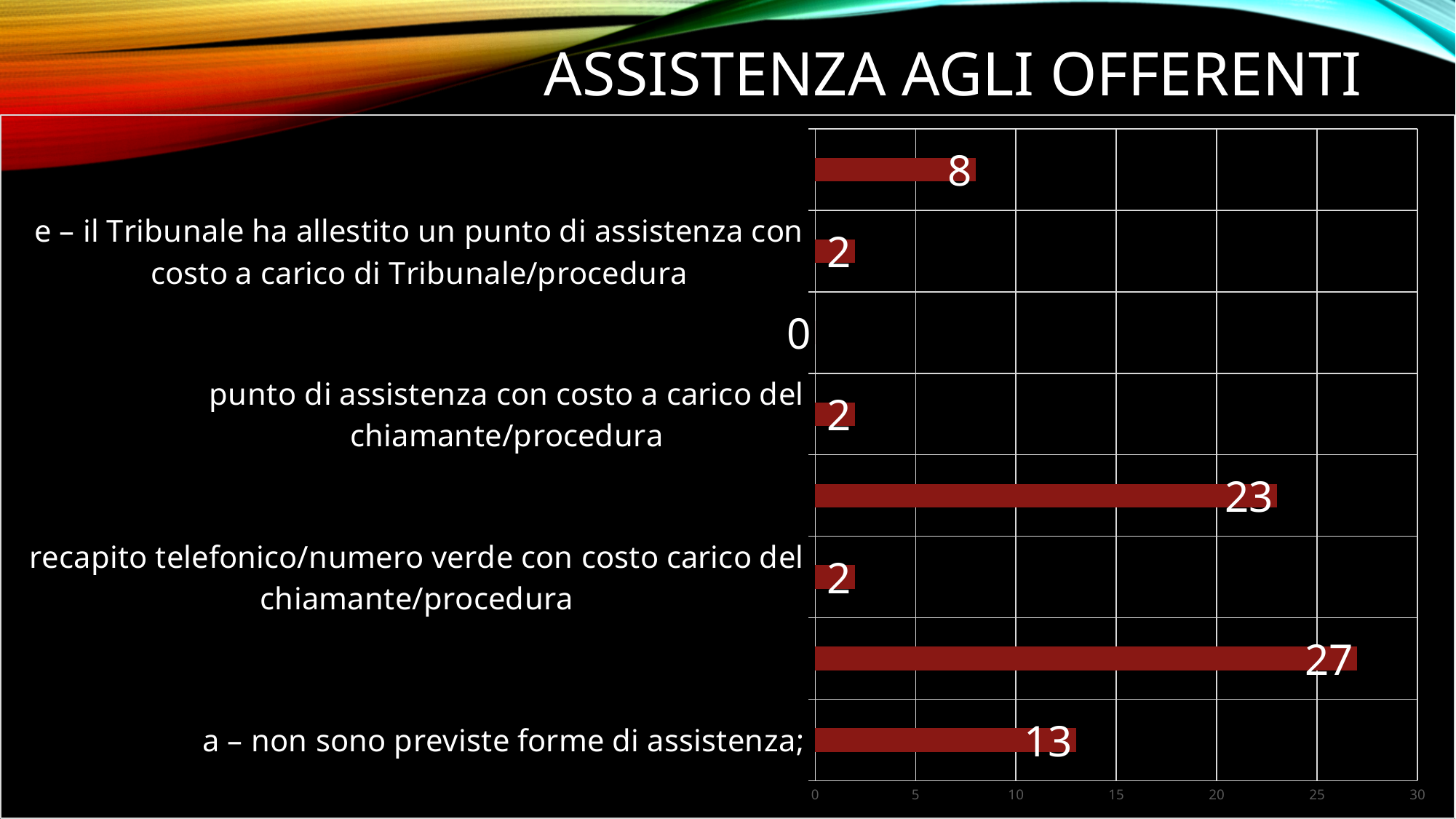
Which is larger: the value for "a – non sono previste forme di assistenza;" or the value for "punto di assistenza con costo a carico del chiamante/procedura"? a – non sono previste forme di assistenza; What is the value for "punto di assistenza con costo a carico del chiamante/procedura"? 2 What is the smallest value shown in the chart? 0 What is the value for "e – il Tribunale ha allestito un punto di assistenza con costo a carico di Tribunale/procedura"? 2 What is the value for "recapito telefonico/numero verde con costo carico del chiamante/procedura"? 2 What is the difference between the value for "a – non sono previste forme di assistenza;" and the value for "recapito telefonico/numero verde con costo carico del chiamante/procedura"? 11 What kind of chart is shown on the slide? bar chart How many bars are plotted in the chart? 7 What is the title of the slide? ASSISTENZA AGLI OFFERENTI What is the value for "a – non sono previste forme di assistenza;"? 13 What is the largest value shown by any bar in the chart? 27 Is the value for "a – non sono previste forme di assistenza;" greater or less than 10? greater